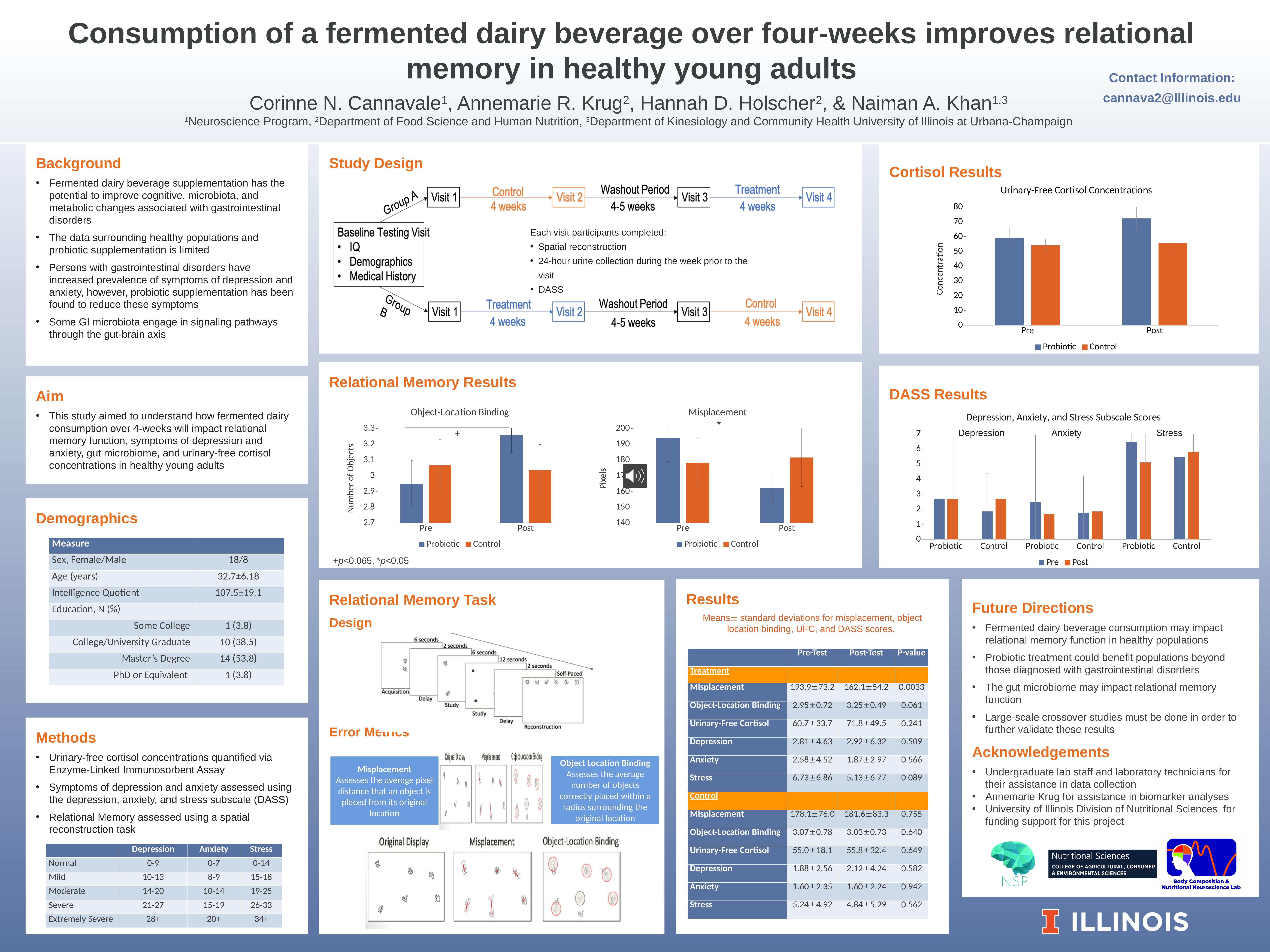
How many category groups are shown on the x axis of the Depression, Anxiety, and Stress Subscale Scores chart? 6 In the Depression, Anxiety, and Stress Subscale Scores chart, which bar is the highest? Stress Probiotic Pre What are the two legend entries of the Depression, Anxiety, and Stress Subscale Scores chart? Pre and Post In the Urinary-Free Cortisol Concentrations chart, which is larger at Post, Probiotic or Control? Probiotic In the Urinary-Free Cortisol Concentrations chart, is the Probiotic value at Post greater or less than 60? greater In the Misplacement chart, does the Probiotic series rise or fall from Pre to Post? fall In the Object-Location Binding chart, is the Probiotic value at Pre greater or less than 3.0? less How many series does the legend of the Urinary-Free Cortisol Concentrations chart list? 2 What kind of chart is the Urinary-Free Cortisol Concentrations chart? bar chart In the Misplacement chart, which is larger at Post, Probiotic or Control? Control In the Object-Location Binding chart, is the Probiotic value at Post greater or less than 3.1? greater